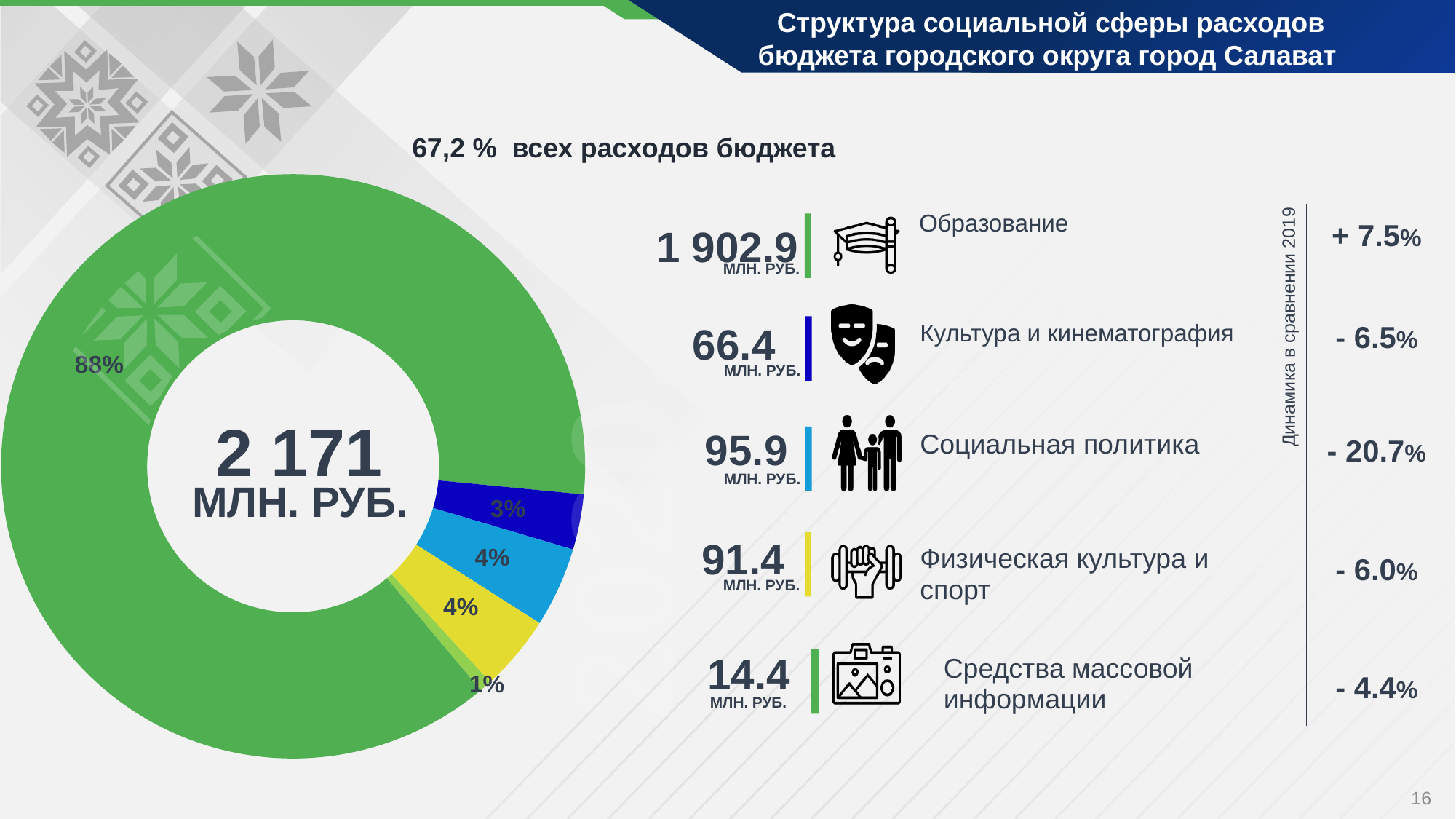
What share of the donut chart does the dark blue slice represent? 3% What kind of chart is shown on the slide? pie chart (donut) What total value is printed in the centre of the donut chart? 2 171 млн. руб. Which category has the lowest value? Средства массовой информации Which is larger: Социальная политика or Физическая культура и спорт? Социальная политика What share of the donut chart does the largest (green) slice represent? 88% What is the value for Социальная политика in млн. руб.? 95.9 How many slices does the donut chart have? 5 Which category has the highest value? Образование What share of the donut chart does the smallest slice represent? 1% What is the value for Образование in млн. руб.? 1 902.9 What is the difference between Культура и кинематография and Средства массовой информации in млн. руб.? 52.0